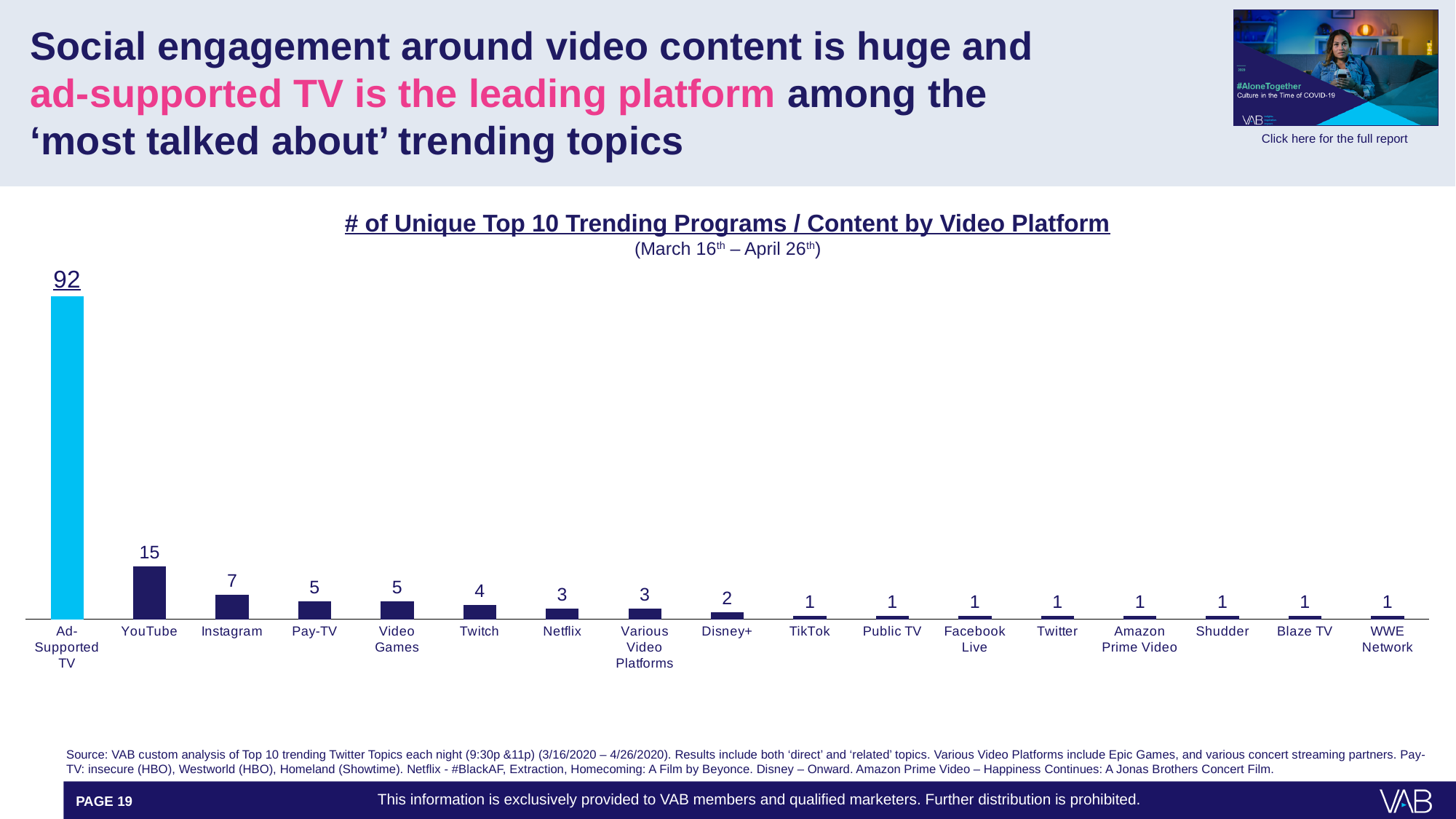
What is the value for Disney+? 2 What is the difference between the values for Ad-Supported TV and YouTube? 77 What kind of chart is shown on the slide? Bar chart Which is larger, the value for Pay-TV or the value for Netflix? Pay-TV How many platforms are shown on the x axis? 17 What is the difference between the values for Instagram and Netflix? 4 Which platform has the highest number of unique top 10 trending programs? Ad-Supported TV What is the value for Twitch? 4 What is the value for YouTube? 15 What is the value for Ad-Supported TV? 92 What date range is given in the chart subtitle? March 16th – April 26th What is the value for Instagram? 7